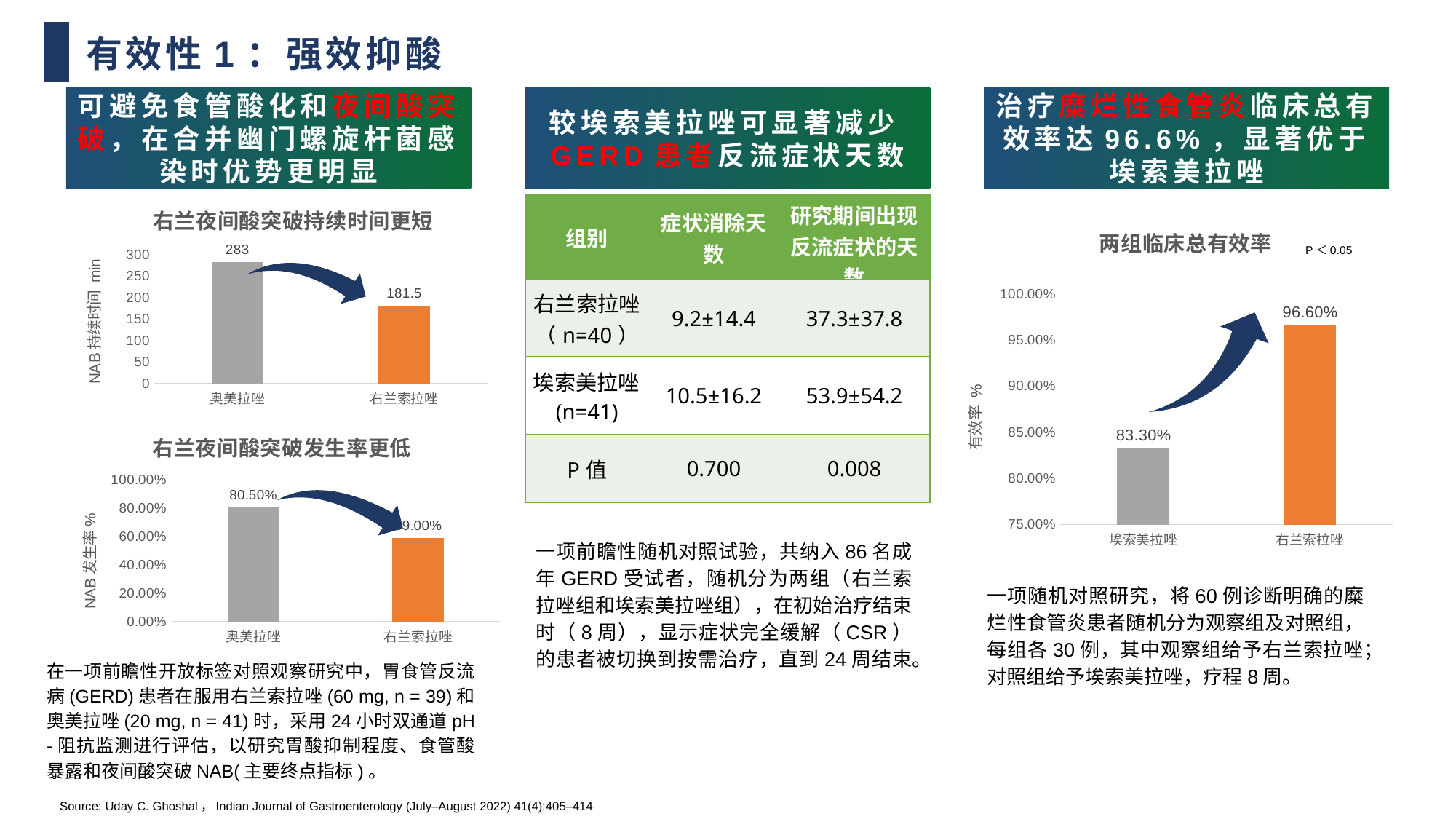
In the chart titled 右兰夜间酸突破持续时间更短, what is the difference between the values for 奥美拉唑 and 右兰索拉唑? 101.5 In the chart titled 右兰夜间酸突破持续时间更短, what is the value for 右兰索拉唑? 181.5 In the chart titled 两组临床总有效率, what is the difference between the values for 右兰索拉唑 and 埃索美拉唑? 13.30% In the chart titled 两组临床总有效率, what is the value for 右兰索拉唑? 96.60% In the chart titled 右兰夜间酸突破发生率更低, what is the value for 奥美拉唑? 80.50% What type of chart is the chart titled 两组临床总有效率? bar chart In the chart titled 右兰夜间酸突破持续时间更短, what is the value for 奥美拉唑? 283 In the chart titled 右兰夜间酸突破发生率更低, is the value for 右兰索拉唑 greater or less than 80.00%? less In the chart titled 右兰夜间酸突破发生率更低, which category has the higher value, 奥美拉唑 or 右兰索拉唑? 奥美拉唑 In the chart titled 两组临床总有效率, what is the value for 埃索美拉唑? 83.30% In the chart titled 两组临床总有效率, how many categories are shown on the x axis? 2 In the chart titled 右兰夜间酸突破持续时间更短, which category has the lowest value? 右兰索拉唑